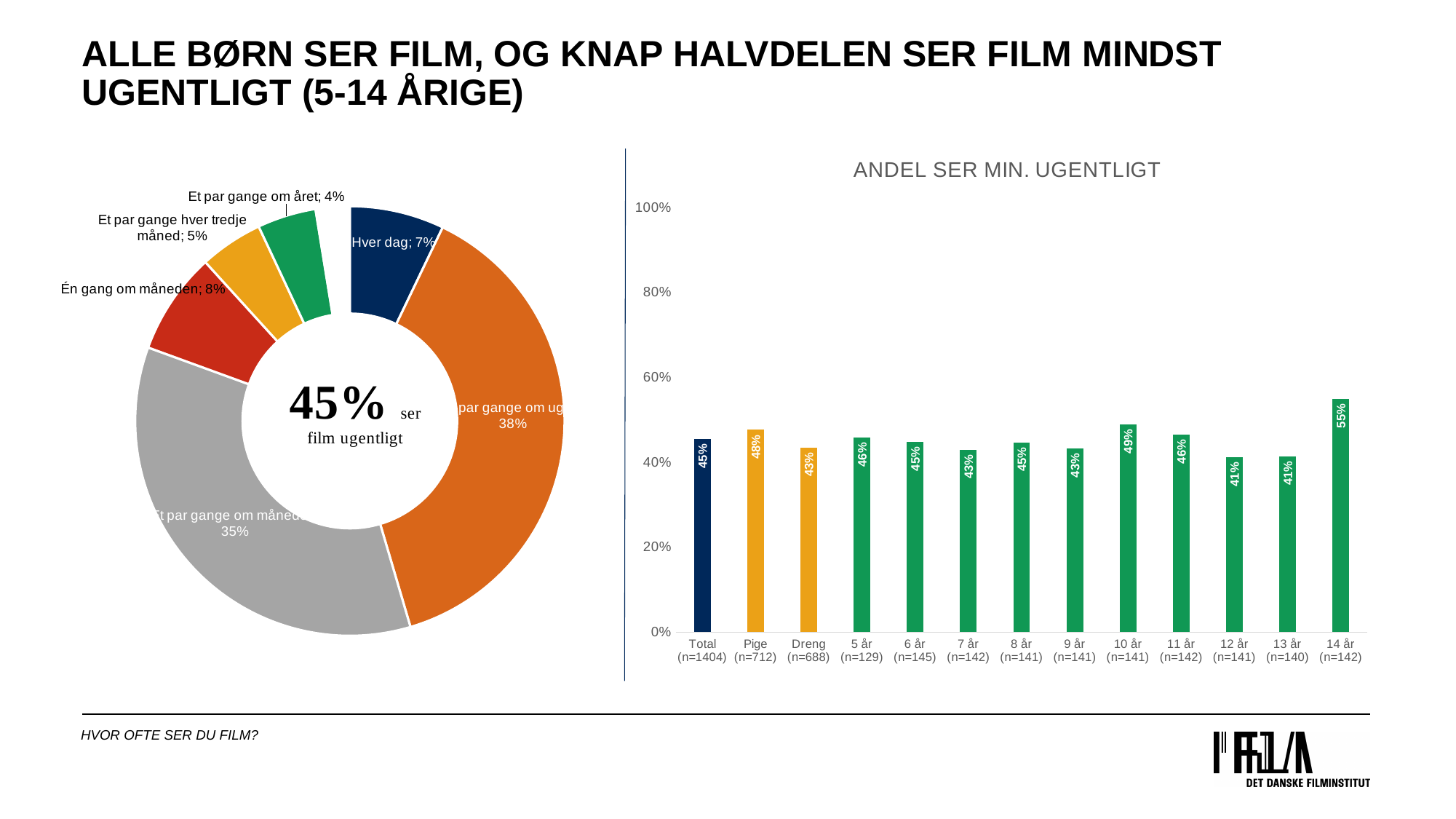
In the bar chart titled "ANDEL SER MIN. UGENTLIGT", what is the value for Pige? 48% In the bar chart titled "ANDEL SER MIN. UGENTLIGT", what is the difference between the values for Pige and Dreng? 5% In the donut chart on the left, what share of children answered "Én gang om måneden"? 8% What percentage is shown in the centre of the donut chart on the left? 45% In the bar chart titled "ANDEL SER MIN. UGENTLIGT", which is larger, the value for 14 år or the value for 12 år? 14 år In the bar chart titled "ANDEL SER MIN. UGENTLIGT", what is the value for Total? 45% In the bar chart titled "ANDEL SER MIN. UGENTLIGT", what is the value for 10 år? 49% In the bar chart titled "ANDEL SER MIN. UGENTLIGT", how many bars are plotted? 13 What kind of chart is the chart on the right side of the slide? Bar chart In the donut chart on the left, what share of children answered "Hver dag"? 7% In the bar chart titled "ANDEL SER MIN. UGENTLIGT", which category has the highest value? 14 år In the donut chart on the left, what is the difference between the shares for "Et par gange hver tredje måned" and "Et par gange om året"? 1%